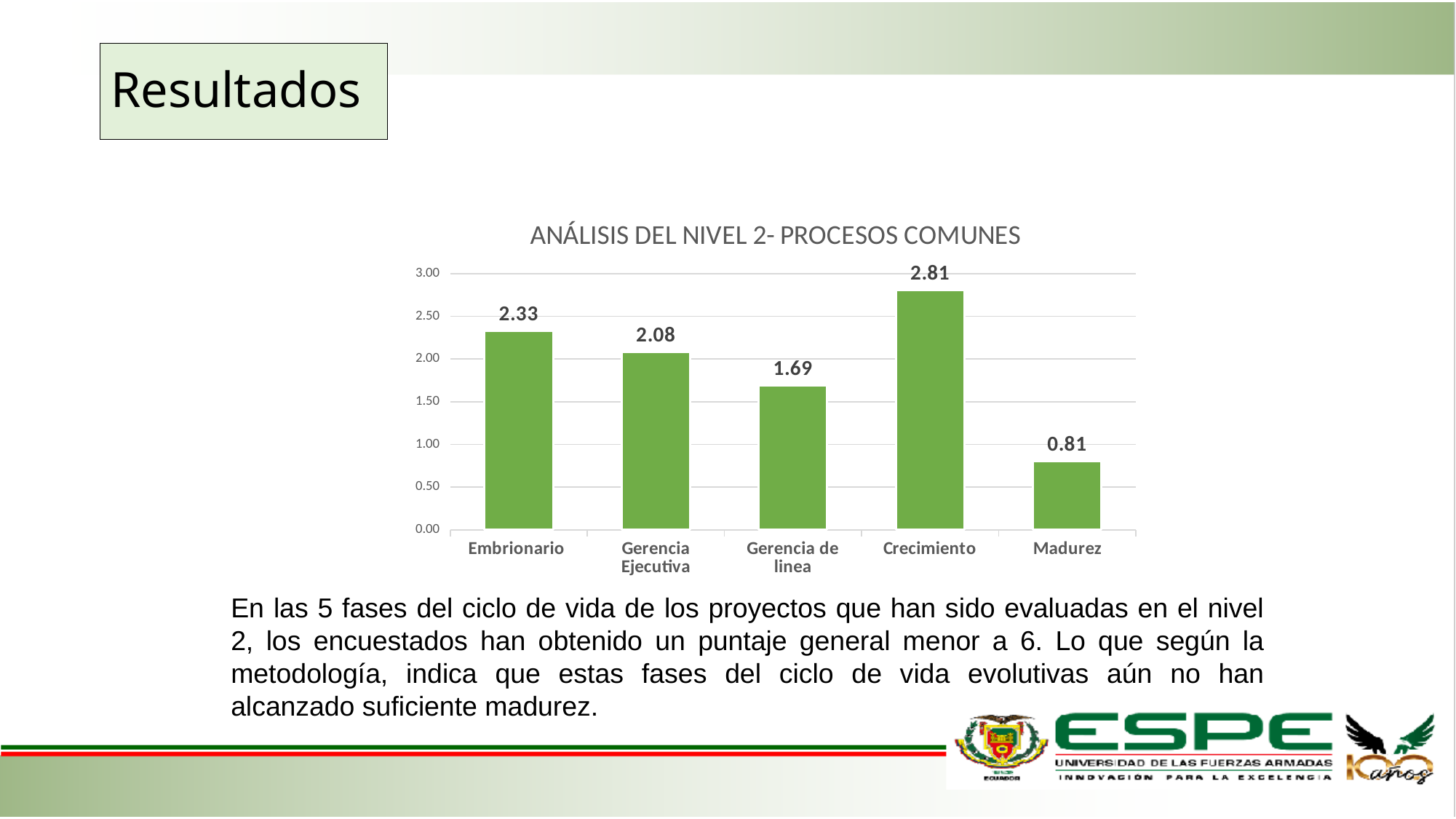
What is the title of the chart? ANÁLISIS DEL NIVEL 2- PROCESOS COMUNES Which category has the lowest value? Madurez What is the value for Madurez? 0.81 What is the value for Gerencia Ejecutiva? 2.08 What is the difference between the values for Crecimiento and Madurez? 2.00 What kind of chart is shown? bar chart Is the value for Gerencia de linea greater or less than 2.00? less Which category has the highest value? Crecimiento What is the value for Embrionario? 2.33 How many categories are shown on the x axis? 5 What is the value for Gerencia de linea? 1.69 Which is larger, the value for Embrionario or the value for Gerencia Ejecutiva? Embrionario